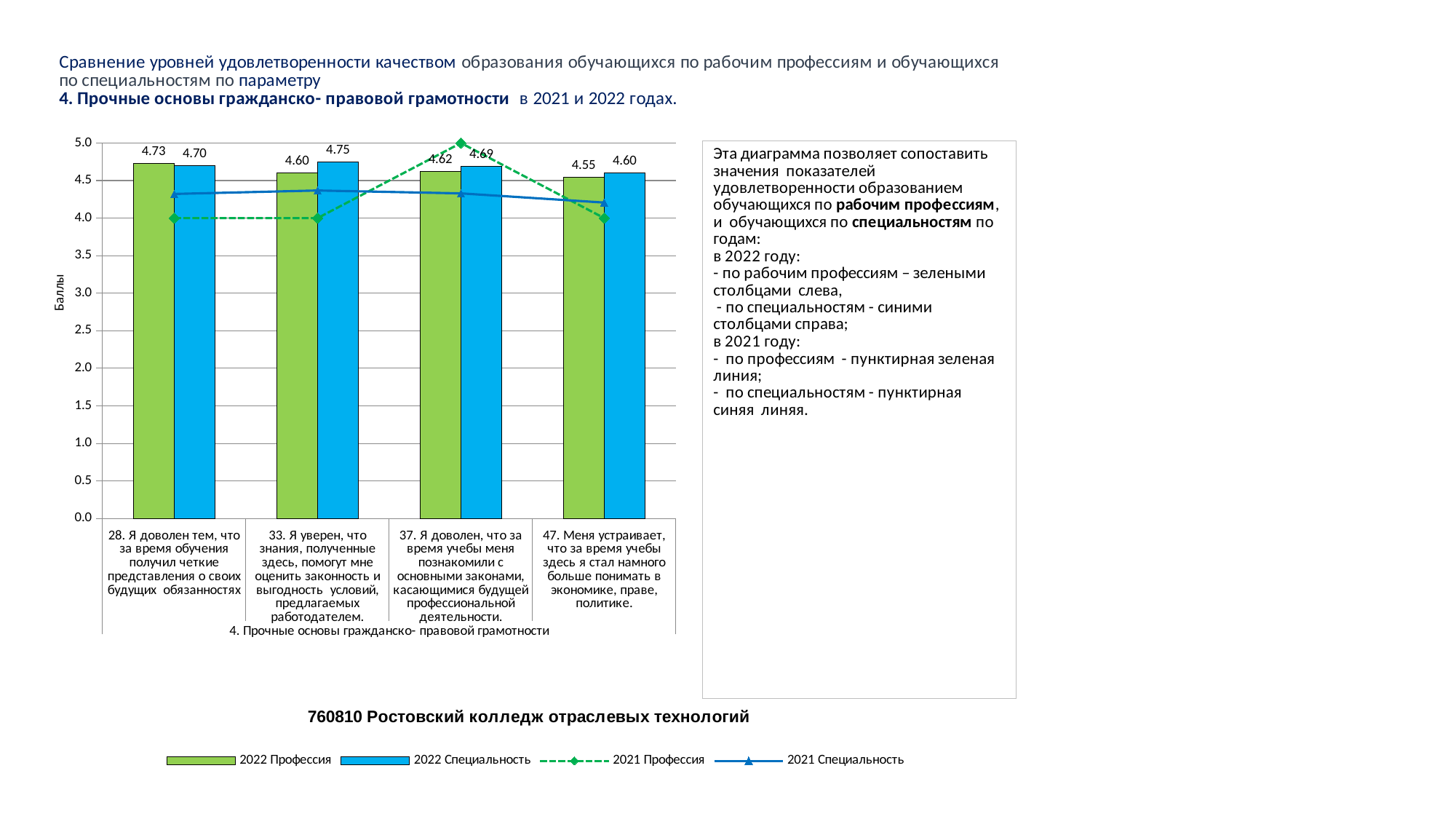
How many categories (survey items) are shown on the x axis? 4 Which category has the lowest 2022 Профессия bar? 47. Меня устраивает, что за время учебы здесь я стал намного больше понимать в экономике, праве, политике For item 28, which is larger: the 2022 Профессия bar or the 2022 Специальность bar? 2022 Профессия What is the value of the 2022 Профессия bar for item 28 (Я доволен тем, что за время обучения получил четкие представления о своих будущих обязанностях)? 4.73 For item 33, what is the difference between the 2022 Специальность and 2022 Профессия values? 0.15 Is the 2021 Профессия line value for item 28 greater or less than 4.5? less What is the label of the vertical axis? Баллы How many series does the legend list? 4 Which category has the highest 2022 Специальность bar? 33. Я уверен, что знания, полученные здесь, помогут мне оценить законность и выгодность условий, предлагаемых работодателем Is the 2021 Профессия line value for item 37 greater or less than 4.5? greater What is the value of the 2022 Специальность bar for item 33 (Я уверен, что знания, полученные здесь, помогут мне оценить законность и выгодность условий, предлагаемых работодателем)? 4.75 What is the value of the 2022 Специальность bar for item 47 (Меня устраивает, что за время учебы здесь я стал намного больше понимать в экономике, праве, политике)? 4.60